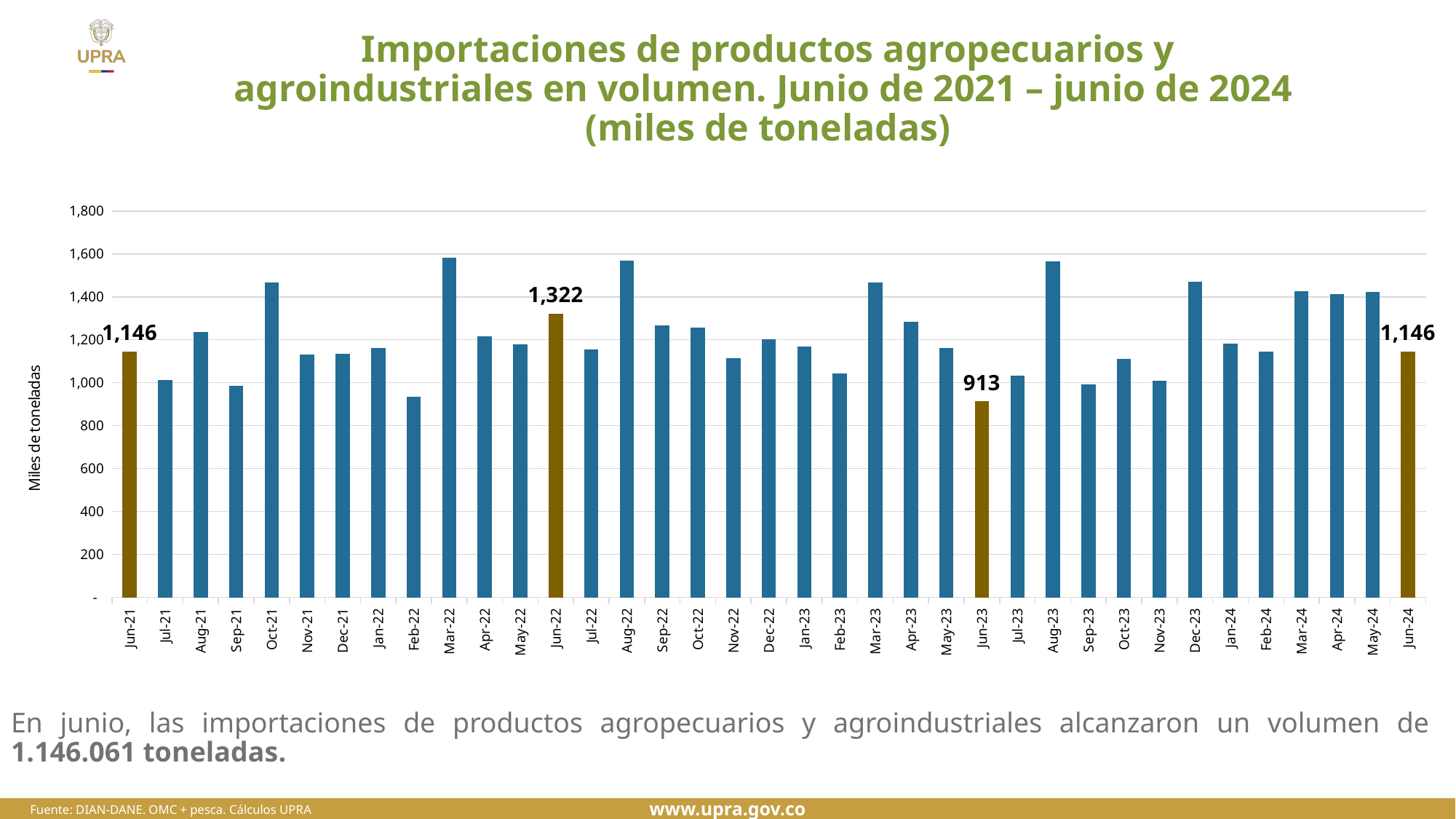
What is the value for Jun-23? 913 Which is larger, the value for Jun-22 or the value for Jun-23? Jun-22 Is the value for Oct-21 greater or less than 1,400? greater Is the value for Aug-23 greater or less than 1,400? greater What is the value for Jun-22? 1,322 What is the value for Jun-24? 1,146 What is the difference between the values for Jun-22 and Jun-23? 409 How many monthly bars are plotted in the chart? 37 What is the value for Jun-21? 1,146 Is the value for Feb-22 greater or less than 1,000? less What is the difference between the values for Jun-22 and Jun-21? 176 What kind of chart is shown on the slide? Bar chart